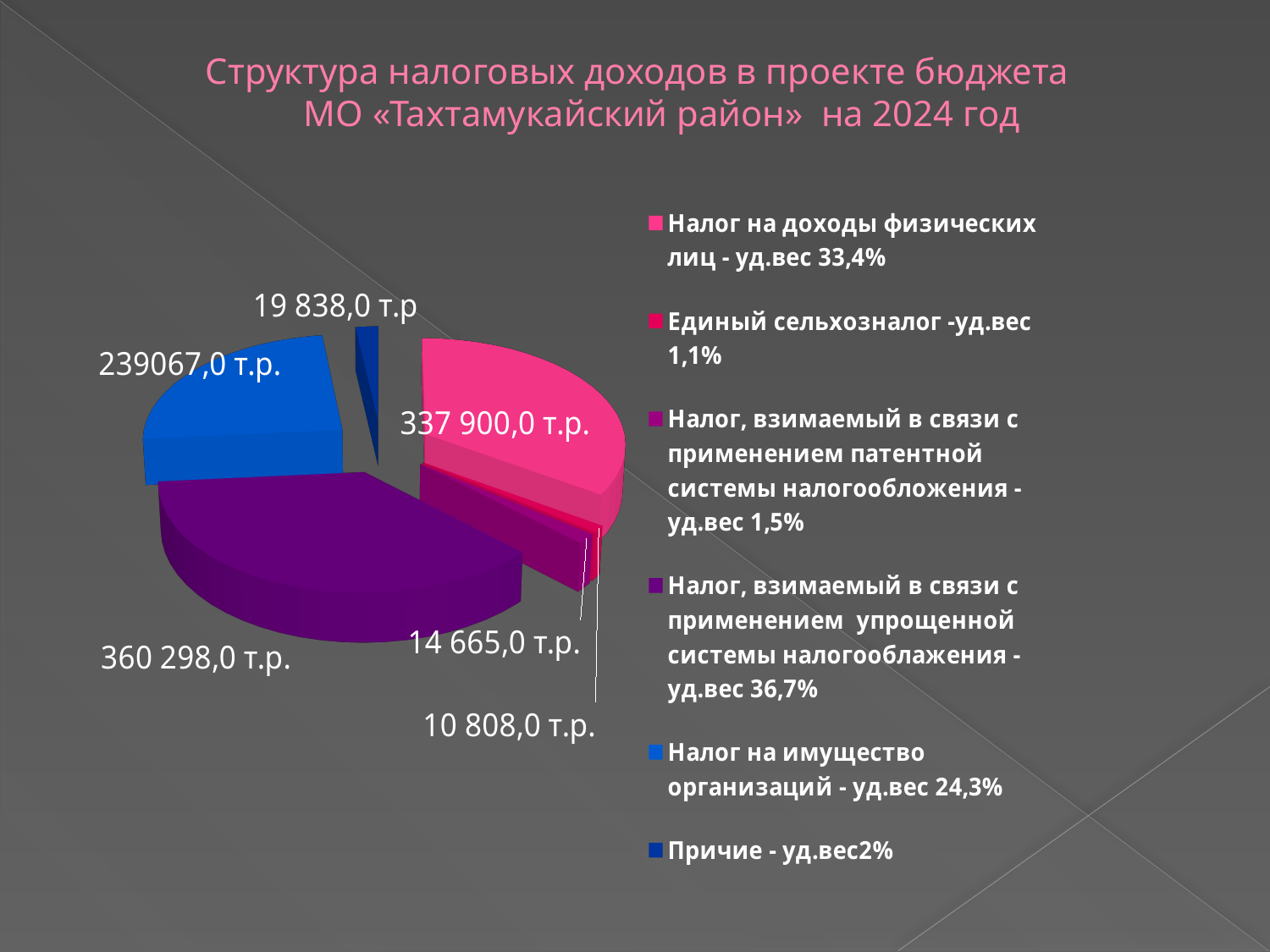
Which is larger: the value for Налог на доходы физических лиц or the value for Налог на имущество организаций? Налог на доходы физических лиц What is the value shown for Причие? 19 838,0 т.р. What is the value shown for Налог на имущество организаций? 239067,0 т.р. Which category has the smallest slice of the pie? Единый сельхозналог What is the difference between the value for Налог на доходы физических лиц and the value for Налог на имущество организаций? 98 833,0 т.р. What is the value shown for Налог на доходы физических лиц? 337 900,0 т.р. What share of the pie does Налог на имущество организаций have, according to the legend? 24,3% What is the value shown for Налог, взимаемый в связи с применением упрощенной системы налогообложения? 360 298,0 т.р. What share of the pie does Единый сельхозналог have, according to the legend? 1,1% How many slices does the pie chart have? 6 What kind of chart is shown on the slide? pie chart Which category has the largest slice of the pie? Налог, взимаемый в связи с применением упрощенной системы налогообложения